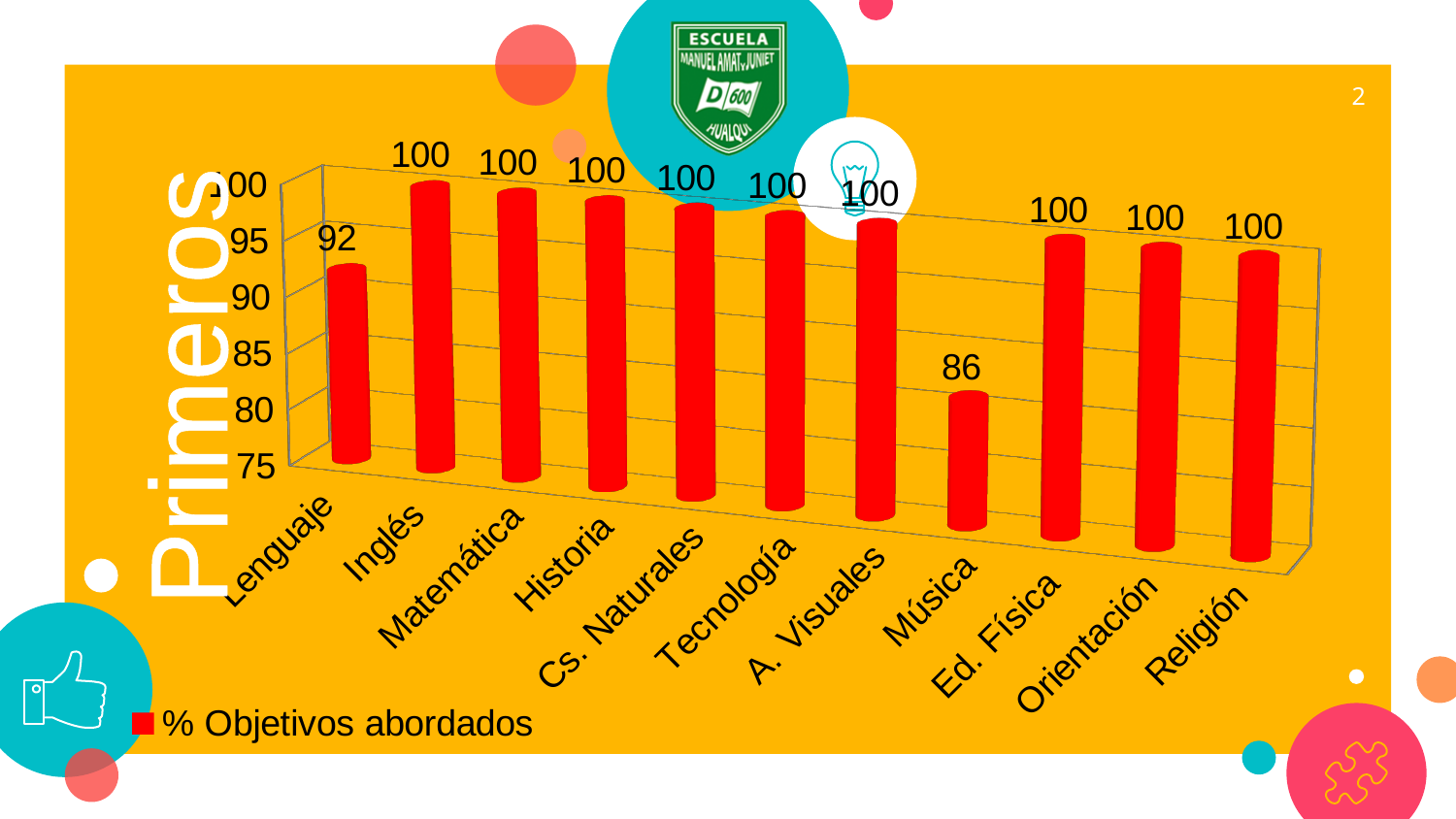
How many categories are shown on the x axis? 11 Which category has the lowest value? Música Which is larger, the value for Lenguaje or the value for Música? Lenguaje What is the legend entry for the series shown? % Objetivos abordados What is the value for Ed. Física? 100 What is the difference between the values for Inglés and Música? 14 How many series does the legend list? 1 What is the value for Música? 86 What is the value for Lenguaje? 92 Is the value for Música greater or less than 90? less What is the difference between the values for Lenguaje and Música? 6 What kind of chart is shown on the slide? bar chart